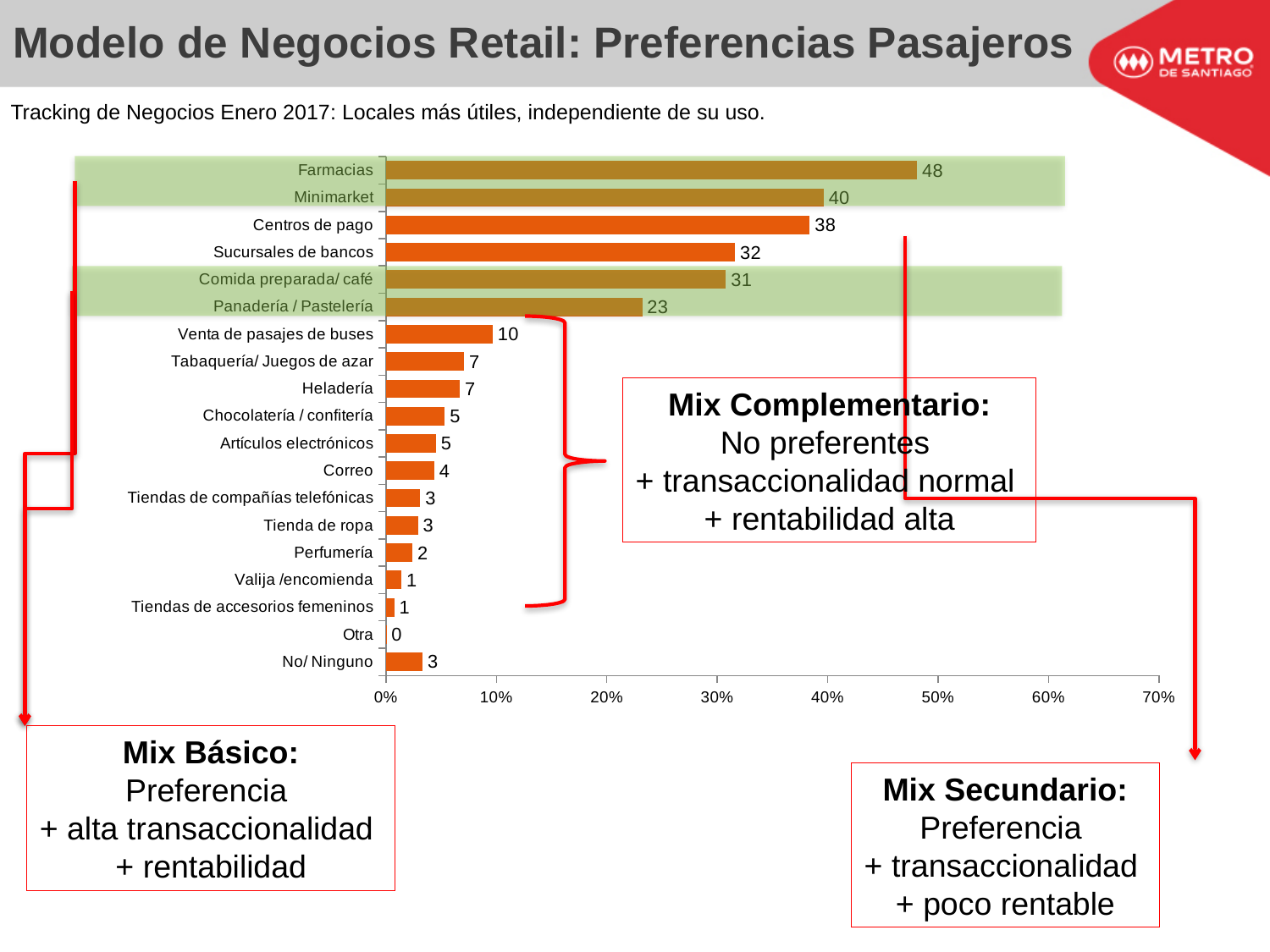
What is the highest value shown on the horizontal axis of the chart? 70% How many categories are plotted in the chart? 19 What is the value shown for Panadería / Pastelería? 23 Which has a larger value, Comida preparada/ café or Panadería / Pastelería? Comida preparada/ café Which category has the lowest value in the chart? Otra Which category has the highest value in the chart? Farmacias What kind of chart is shown on the slide? Bar chart What is the difference between the values for Farmacias and Minimarket? 8 What is the difference between the values for Centros de pago and Sucursales de bancos? 6 What is the value shown for Venta de pasajes de buses? 10 Which has a larger value, Correo or Perfumería? Correo What is the value shown for Farmacias? 48